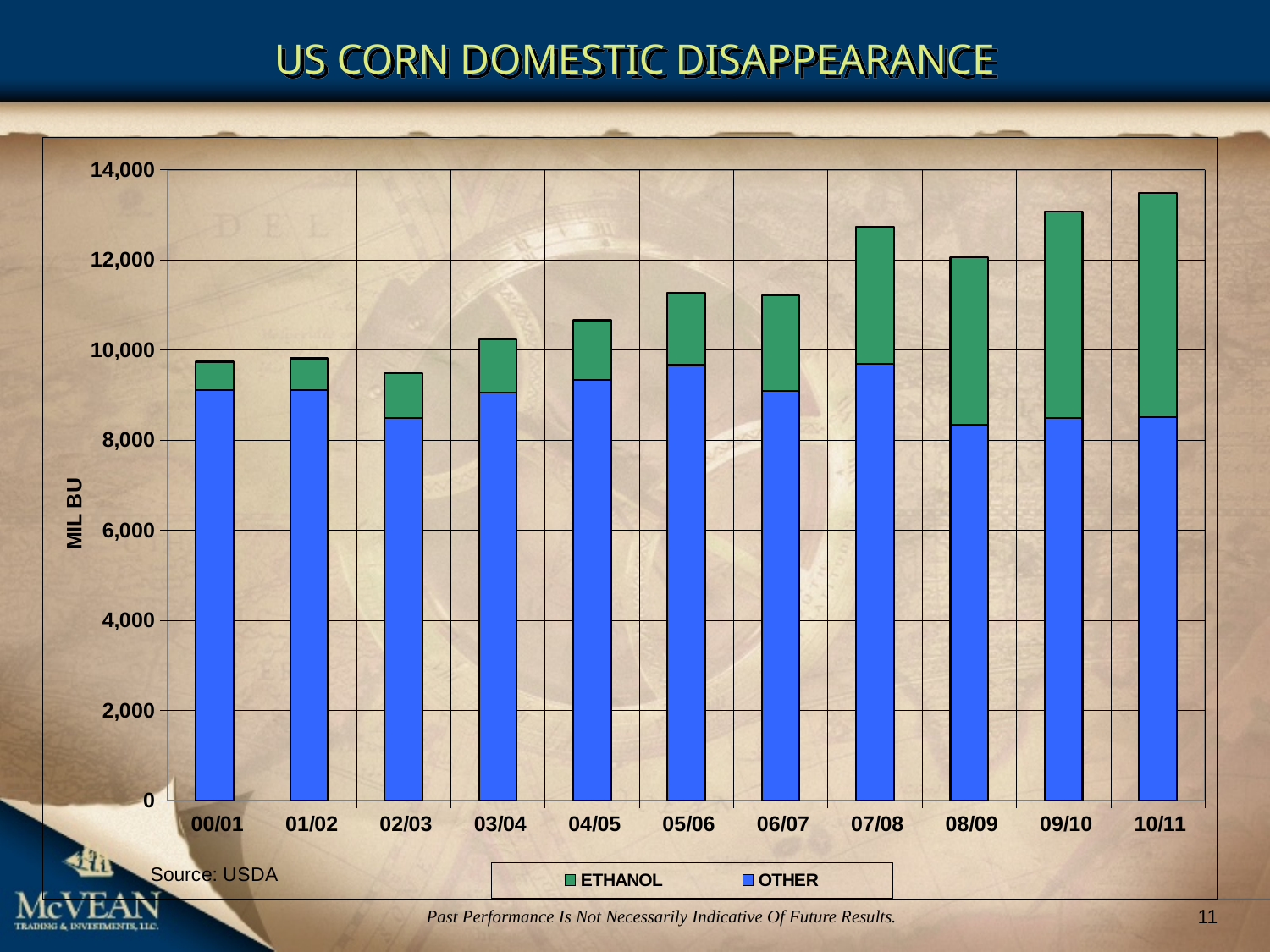
Is the OTHER portion of the 10/11 bar greater or less than 10,000? less Which colour represents ETHANOL in the legend? Green Is the total bar for 07/08 larger or smaller than the total bar for 08/09? larger Is the total bar for 00/01 greater or less than 10,000? less Which year has the highest total domestic disappearance? 10/11 What kind of chart is shown on the slide? Stacked bar chart Is the total bar for 07/08 greater or less than 12,000? greater Does the ETHANOL portion of the bars generally rise or fall from 00/01 to 10/11? rise How many marketing years are shown on the x axis? 11 How many series does the legend list? 2 What is the title of the chart? US CORN DOMESTIC DISAPPEARANCE